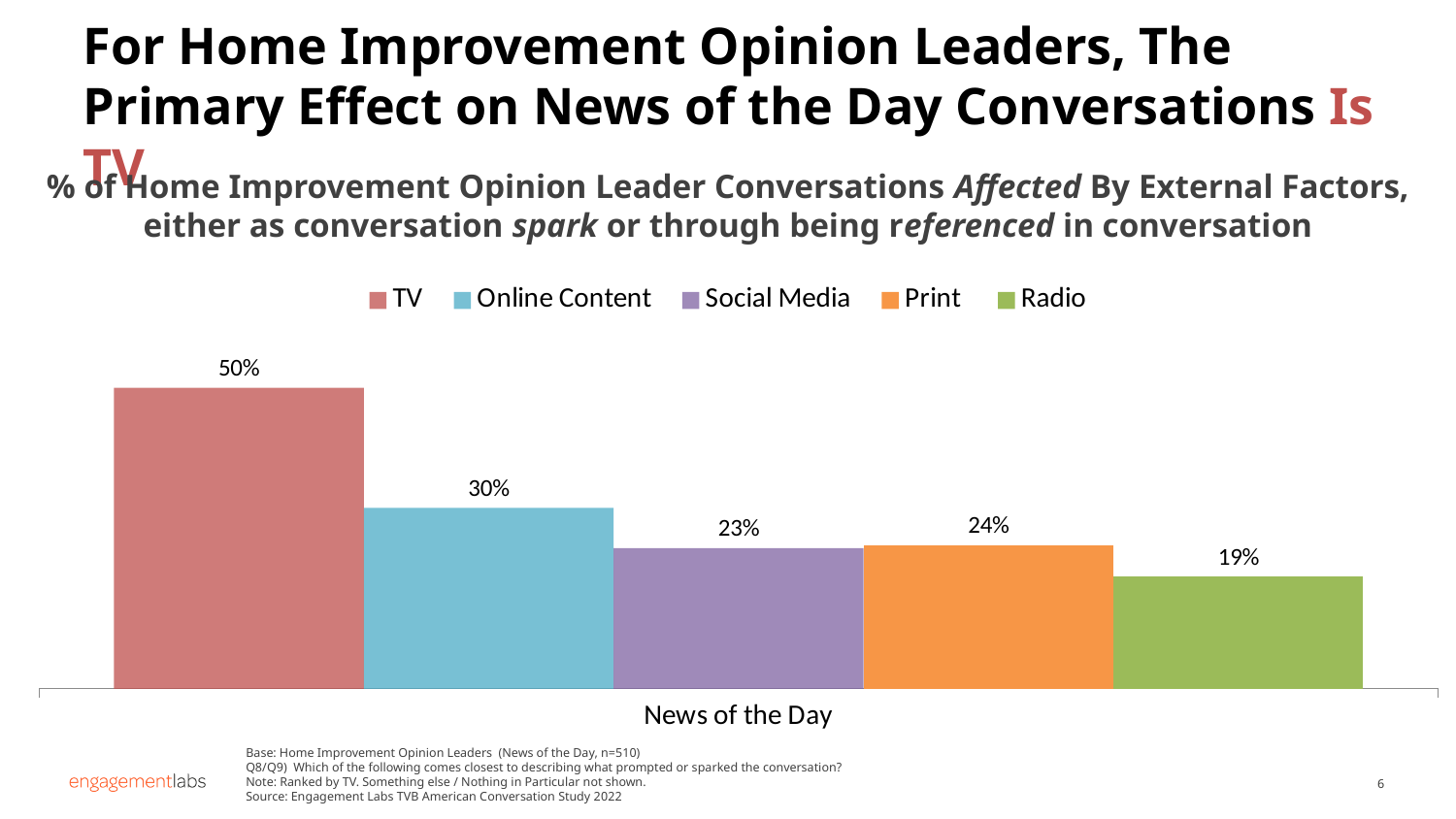
How many series does the legend list? 5 What is the value for Social Media? 23% Which series has the lowest value? Radio What is the difference between the values for Print and Social Media? 1% What is the value for TV? 50% What kind of chart is shown on the slide? Bar chart What is the value for Radio? 19% What is the category label shown on the x axis? News of the Day What is the value for Online Content? 30% Which is larger, the value for Online Content or the value for Print? Online Content Which series has the highest value? TV What is the difference between the values for TV and Online Content? 20%